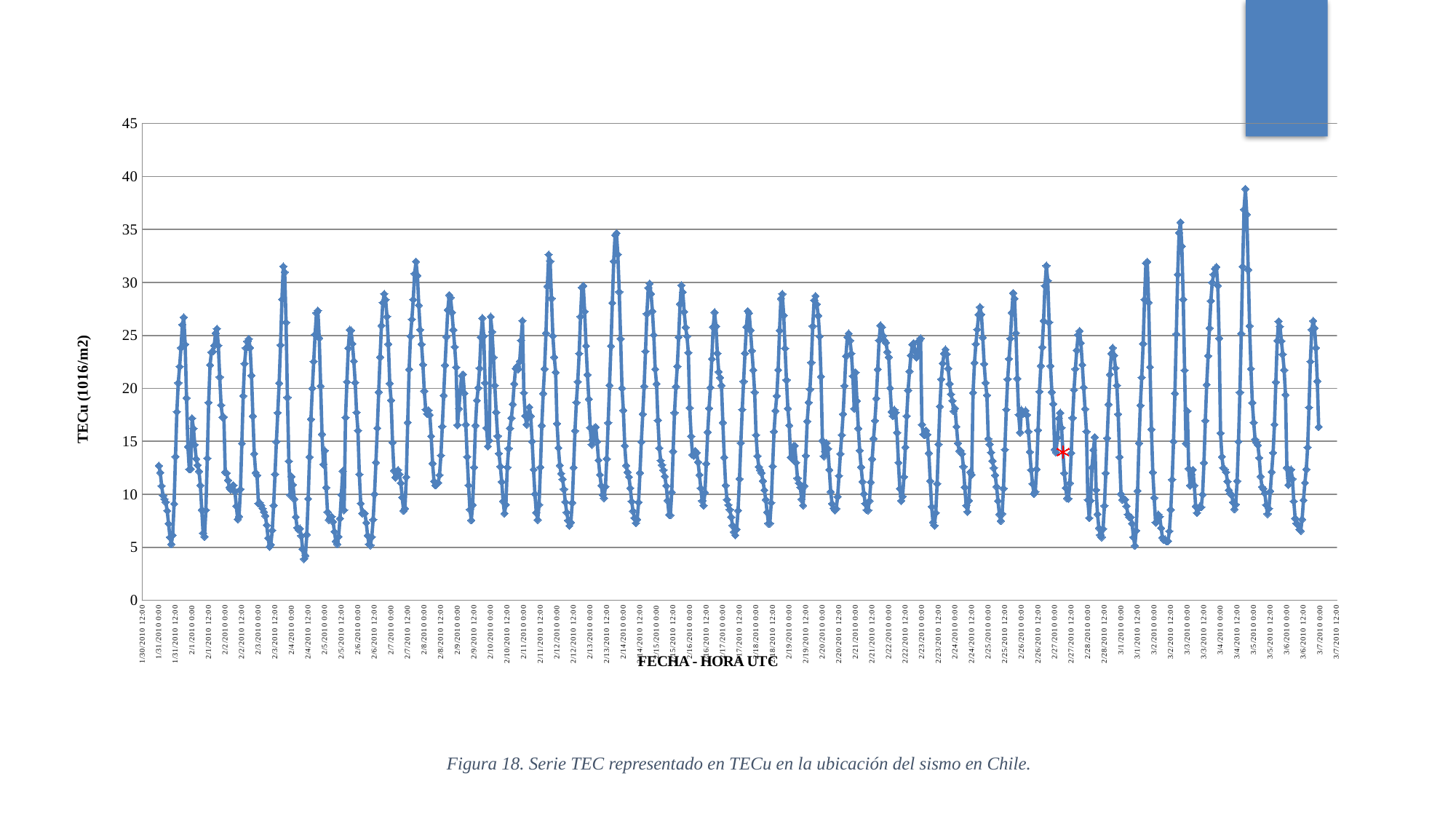
Is the lowest value near 2/4/2010 12:00 greater or less than 5? less Is the peak near 2/22/2010 12:00 greater or less than 30? less Is the peak near 2/14/2010 0:00 greater or less than 30? greater Is the peak near 3/5/2010 0:00 higher than the peak near 2/14/2010 0:00? yes What is the label of the x axis? FECHA - HORA UTC What kind of chart is shown on the slide? line chart What is the label of the y axis? TECu (1016/m2) What is the highest value shown on the y axis? 45